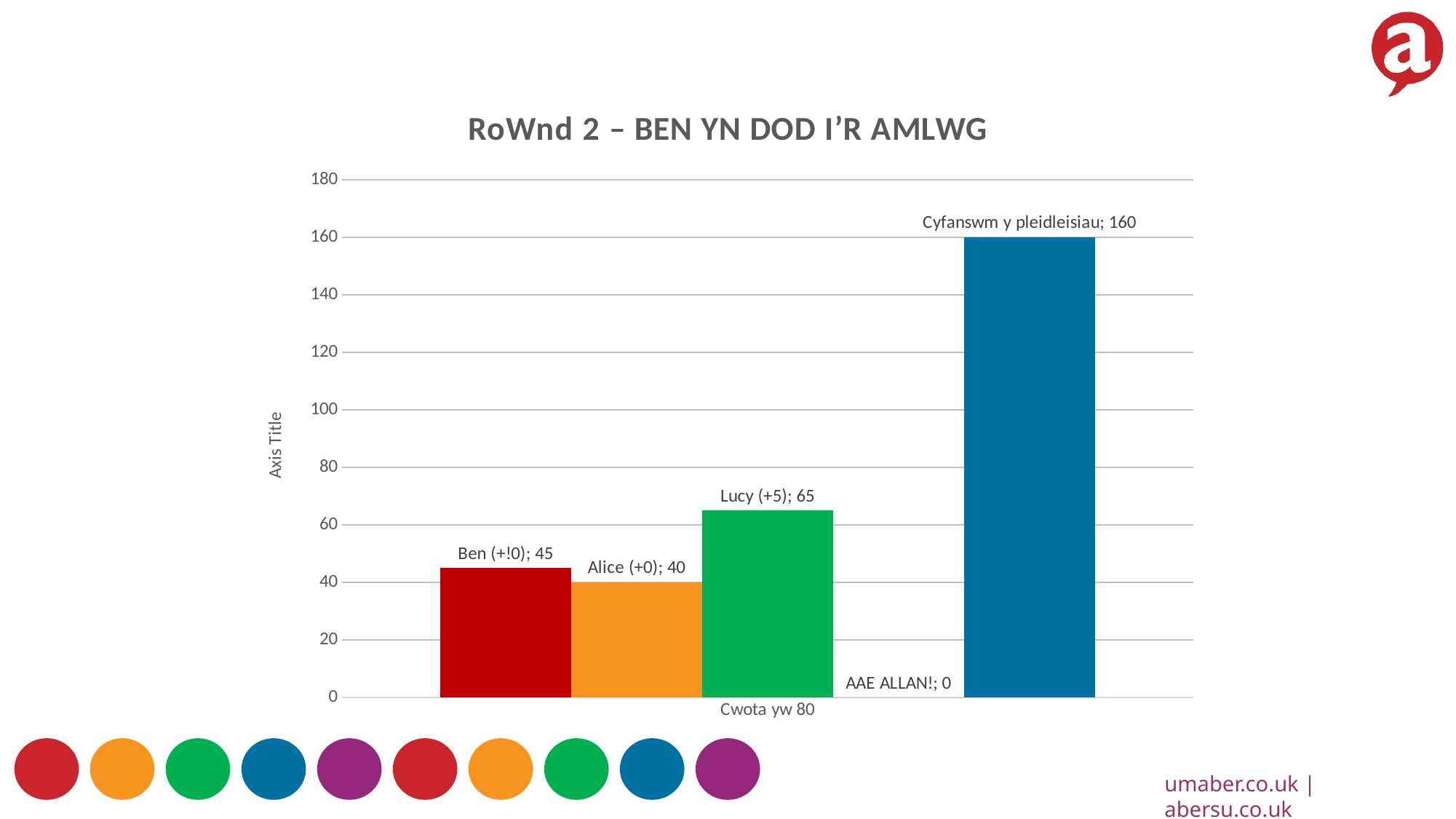
What is the title of the chart? RoWnd 2 – BEN YN DOD I'R AMLWG What value is shown for Ben on the chart? 45 What value is shown for 'AAE ALLAN!' on the chart? 0 What type of chart is shown on the slide? Bar chart What value is shown for Alice on the chart? 40 How many bars are plotted on the chart? 4 What value is shown for 'Cyfanswm y pleidleisiau' on the chart? 160 What is the difference between Lucy's value and Ben's value? 20 Which bar has the highest value on the chart? Cyfanswm y pleidleisiau Which is larger, Ben's value or Alice's value? Ben What value is shown for Lucy on the chart? 65 Which bar has the lowest value on the chart? AAE ALLAN!